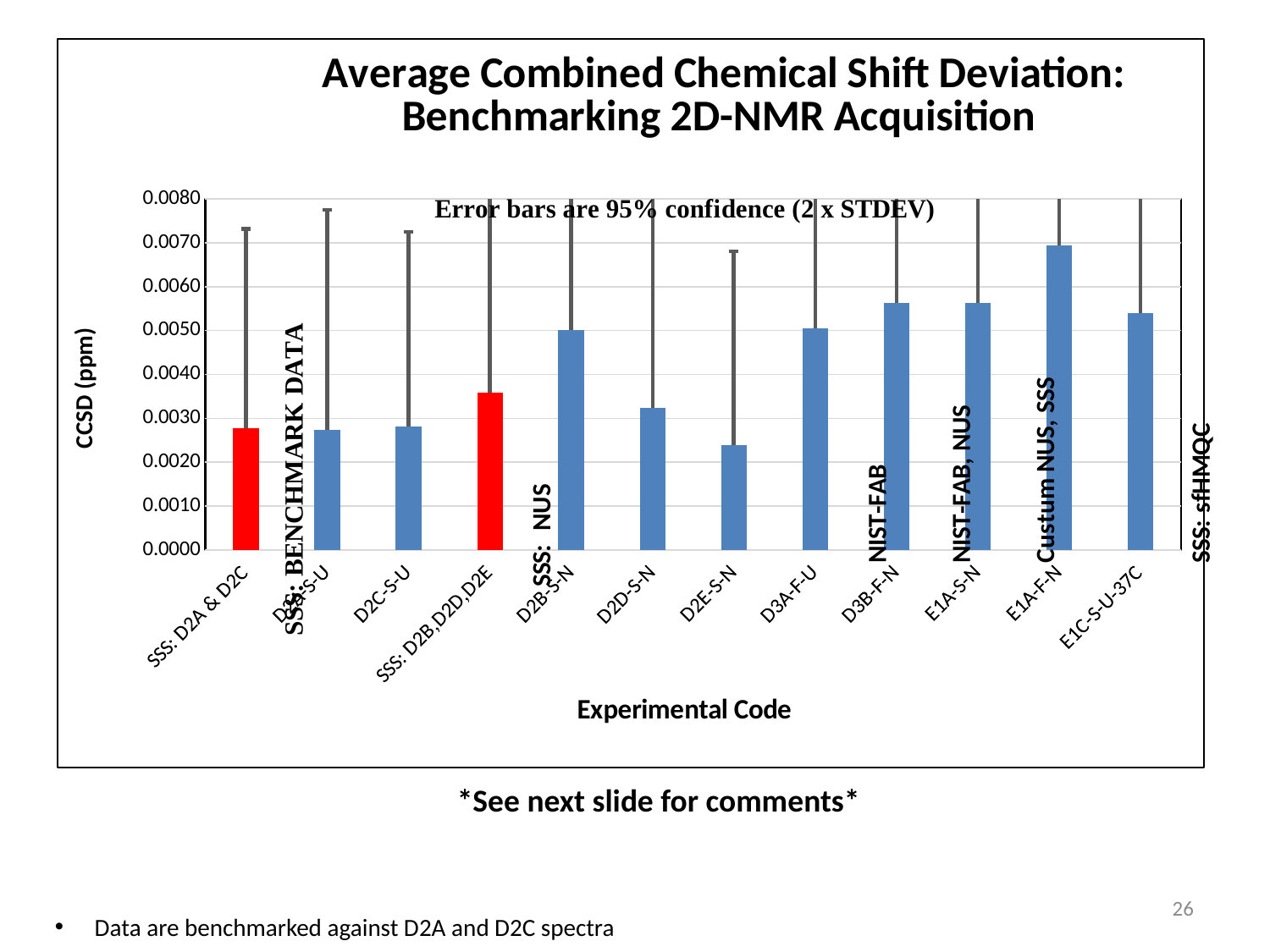
What kind of chart is shown on the slide? Bar chart According to the note on the chart, what do the error bars represent? 95% confidence (2 x STDEV) Which experimental code has the highest CCSD value? E1A-F-N Which experimental code has the lowest CCSD value? D2E-S-N Is the CCSD value for E1A-F-N greater or less than 0.0060? greater Which has the larger CCSD value, D2B-S-N or D2D-S-N? D2B-S-N Is the CCSD value for D3B-F-N greater or less than 0.0050? greater Is the CCSD value for SSS: D2B,D2D,D2E greater or less than 0.0040? less How many experimental codes (bars) are plotted on the chart? 12 Which has the larger CCSD value, E1A-F-N or D3B-F-N? E1A-F-N What is the label of the vertical axis of the chart? CCSD (ppm)